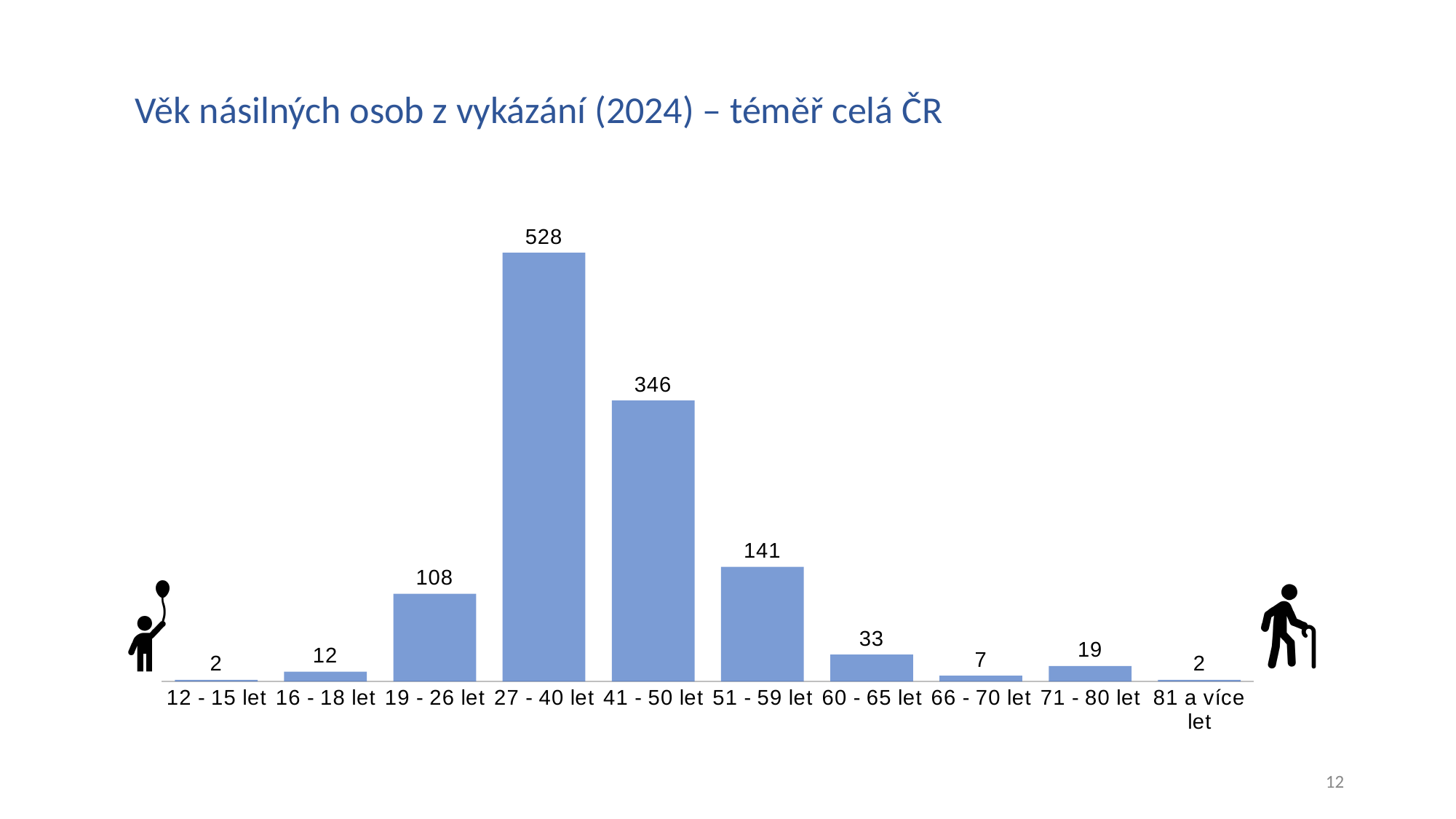
What is the difference between the values for 19 - 26 let and 60 - 65 let? 75 What is the value for the 71 - 80 let category? 19 What is the value for the 51 - 59 let category? 141 What is the title of the slide? Věk násilných osob z vykázání (2024) – téměř celá ČR What kind of chart is shown on the slide? bar chart What is the value for the 27 - 40 let category? 528 Which age category has the highest value? 27 - 40 let What is the difference between the values for 27 - 40 let and 41 - 50 let? 182 How many age categories are shown on the x axis? 10 Which is larger, the value for 16 - 18 let or the value for 66 - 70 let? 16 - 18 let Which is larger, the value for 41 - 50 let or the value for 51 - 59 let? 41 - 50 let Do the values rise or fall from 27 - 40 let to 66 - 70 let? fall